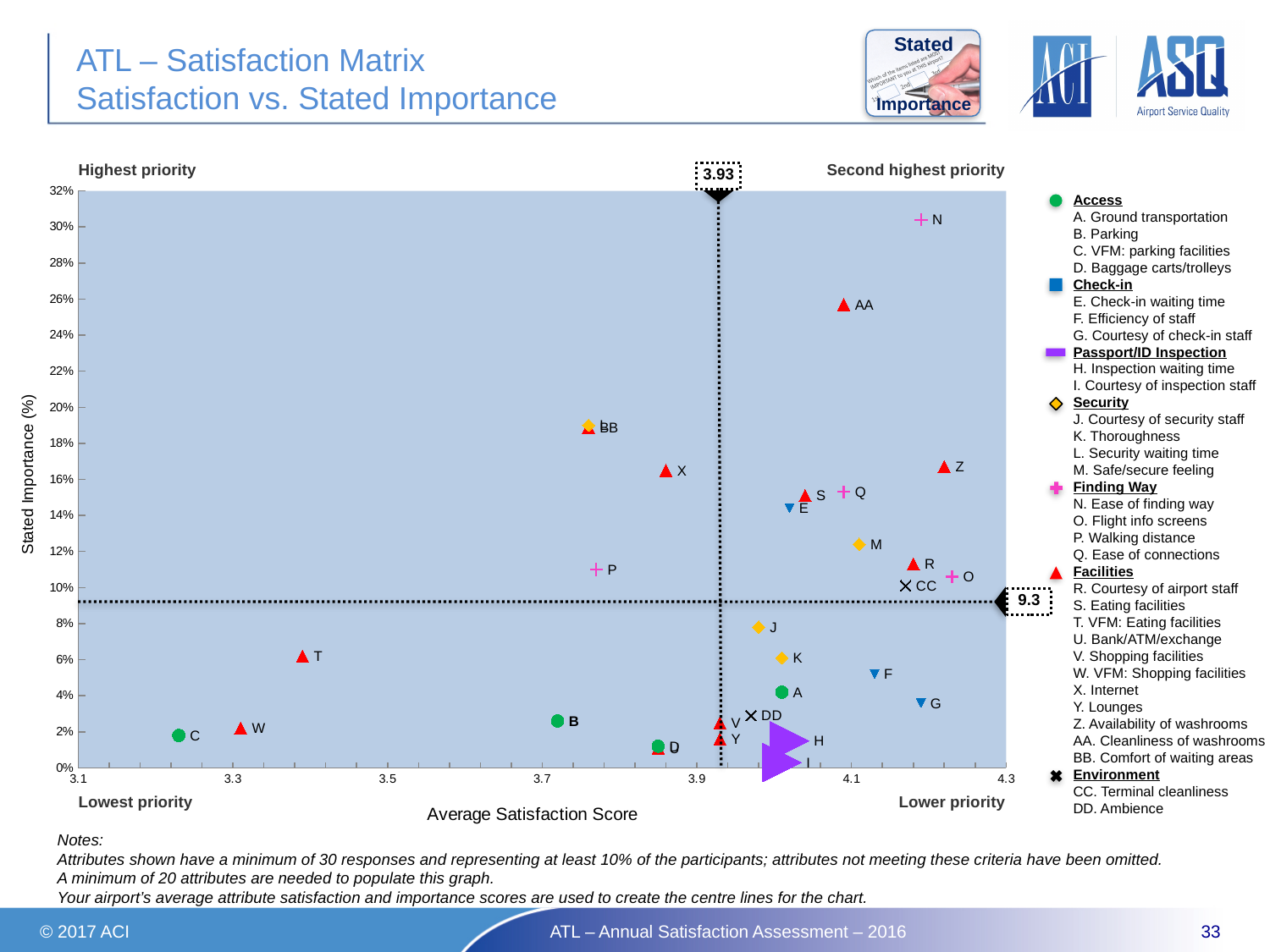
Which has a higher stated importance, N or T? N Is the stated importance for T greater or less than 8%? less What value is marked on the horizontal centre line of the chart? 9.3 What is the label of the x axis? Average Satisfaction Score Which attribute has the highest stated importance? N Is the average satisfaction score for C greater or less than 3.3? less Is the stated importance for AA greater or less than 24%? greater How many attribute groups does the legend list? 7 Which attribute has the lowest average satisfaction score? C What kind of chart is shown on the slide? scatter chart What value is marked on the vertical centre line of the chart? 3.93